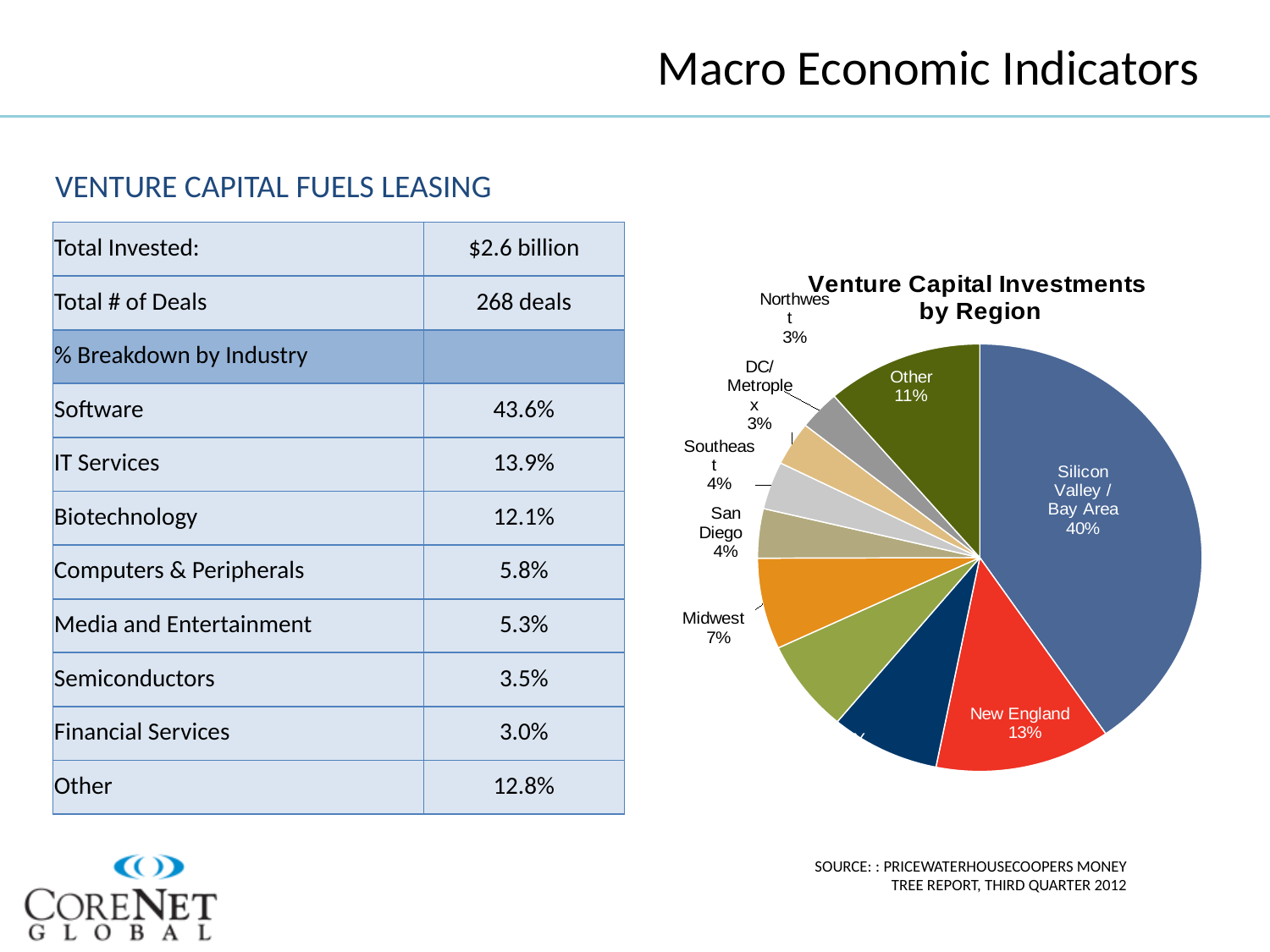
What percentage is shown for the Other region in the pie chart? 11% Which has a larger share in the pie chart, New England or Other? New England What type of chart is shown on the slide? pie chart What share of venture capital investments does Silicon Valley / Bay Area account for in the pie chart? 40% What percentage is shown for San Diego in the pie chart? 4% What percentage is shown for New England in the pie chart? 13% Which region has the largest slice in the pie chart? Silicon Valley / Bay Area What percentage is shown for the Midwest in the pie chart? 7% How many percentage points larger is the Other share than the Midwest share? 4% How many percentage points larger is the Silicon Valley / Bay Area share than the New England share? 27% What percentage is shown for the Northwest in the pie chart? 3% What is the title of the chart on the slide? Venture Capital Investments by Region